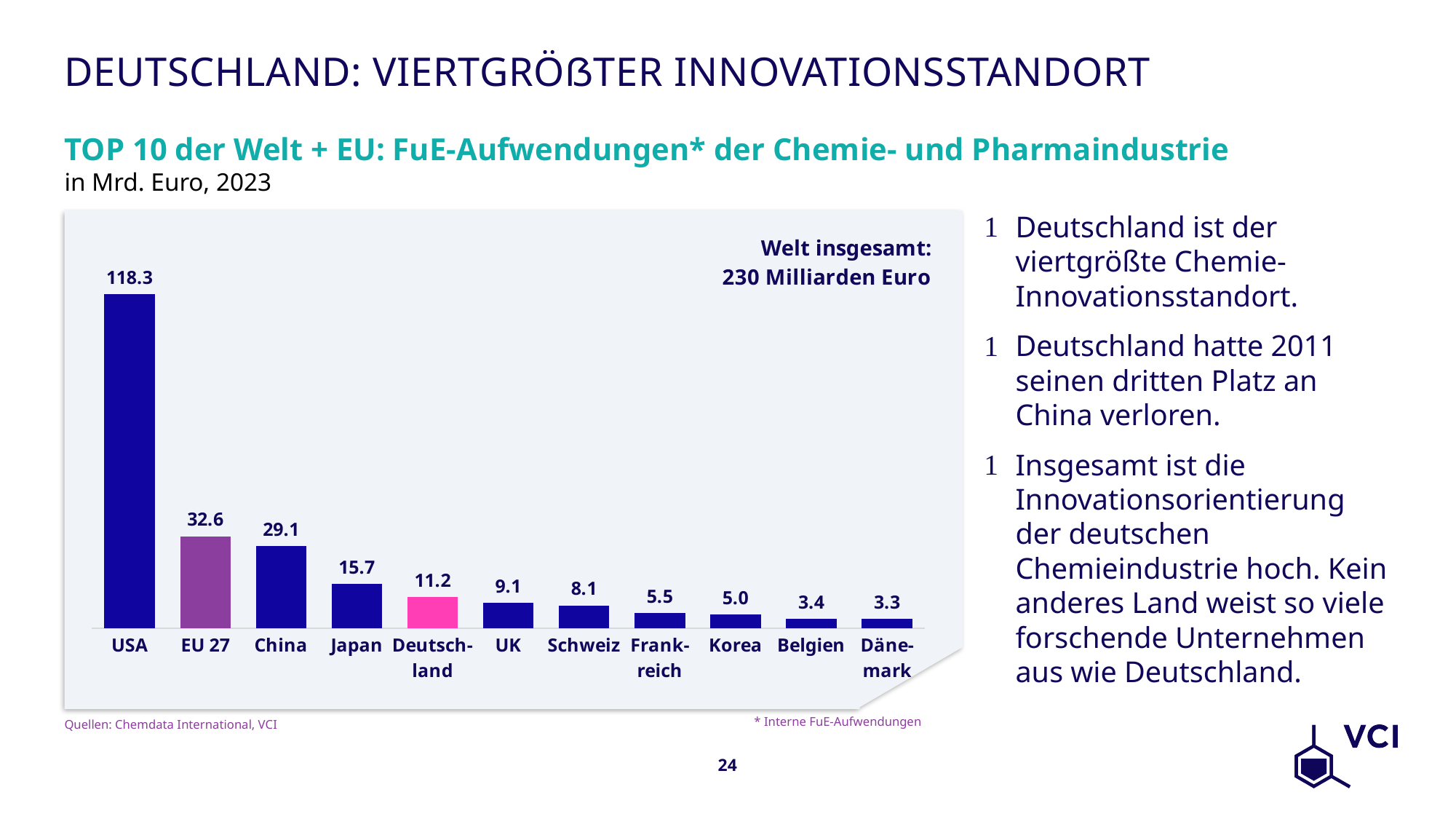
What is the value for USA? 118.3 Which bar is coloured pink? Deutschland What world total is stated in the chart? 230 Milliarden Euro Which category has the lowest value? Dänemark What is the value for Deutschland? 11.2 What kind of chart is shown on the slide? Bar chart What is the difference between the values for EU 27 and China? 3.5 What is the difference between the values for Japan and Deutschland? 4.5 Which is larger, the value for UK or the value for Korea? UK How many categories are shown in the chart? 11 What is the value for Schweiz? 8.1 Which category has the highest value? USA